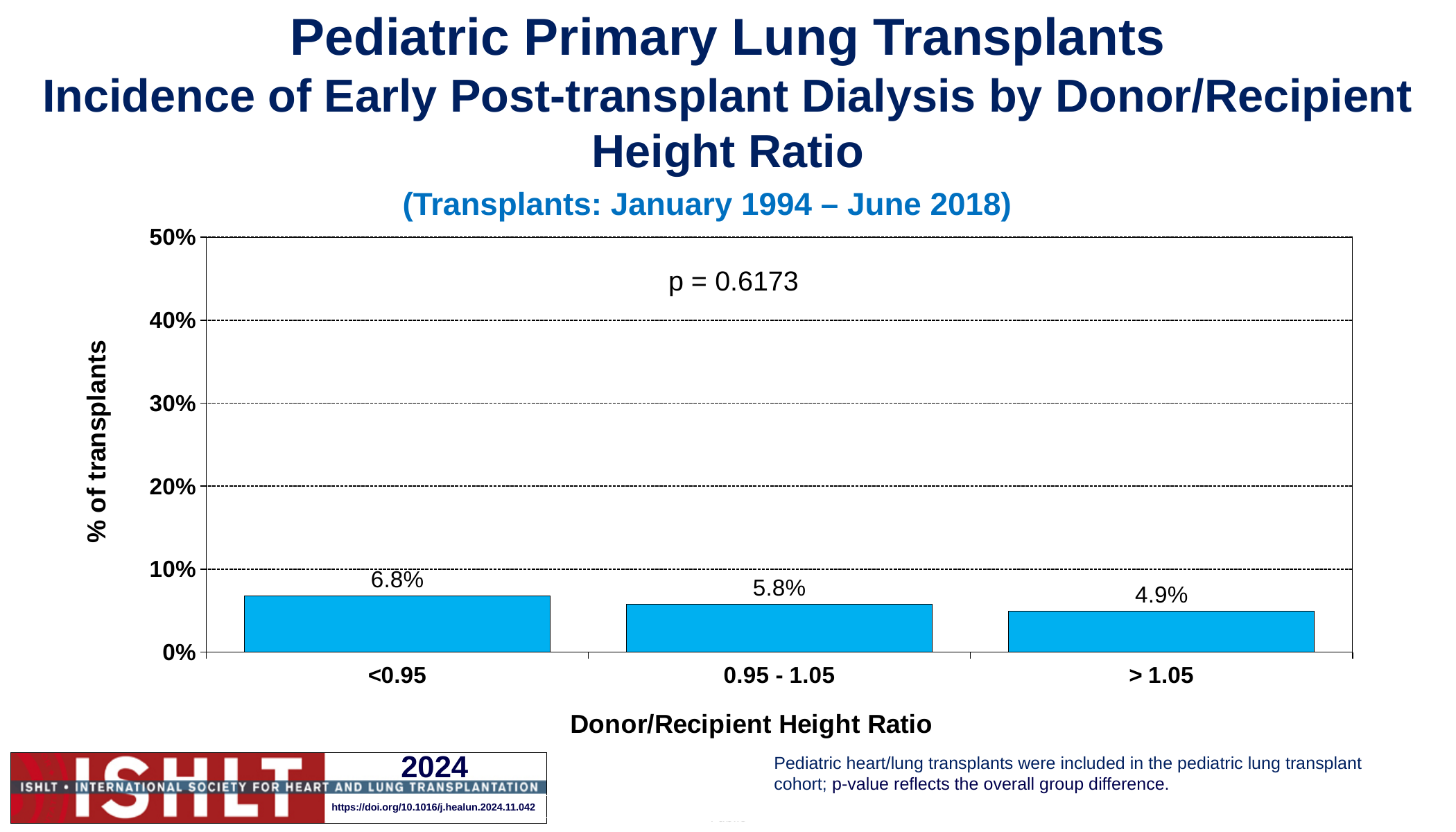
What is the percentage of transplants with early post-transplant dialysis for the 0.95 - 1.05 height ratio group? 5.8% What is the difference in dialysis incidence between the <0.95 group and the > 1.05 group? 1.9% What is the percentage of transplants with early post-transplant dialysis for the <0.95 height ratio group? 6.8% How many donor/recipient height ratio categories are shown on the chart? 3 Which donor/recipient height ratio group has the highest incidence of early post-transplant dialysis? <0.95 Which donor/recipient height ratio group has the lowest incidence of early post-transplant dialysis? > 1.05 What p-value is shown on the chart? p = 0.6173 Which group has a higher dialysis incidence, 0.95 - 1.05 or > 1.05? 0.95 - 1.05 Is the value for the <0.95 group greater or less than 10%? less What is the difference in dialysis incidence between the <0.95 group and the 0.95 - 1.05 group? 1.0% What is the percentage of transplants with early post-transplant dialysis for the > 1.05 height ratio group? 4.9% What kind of chart is shown on the slide? Bar chart